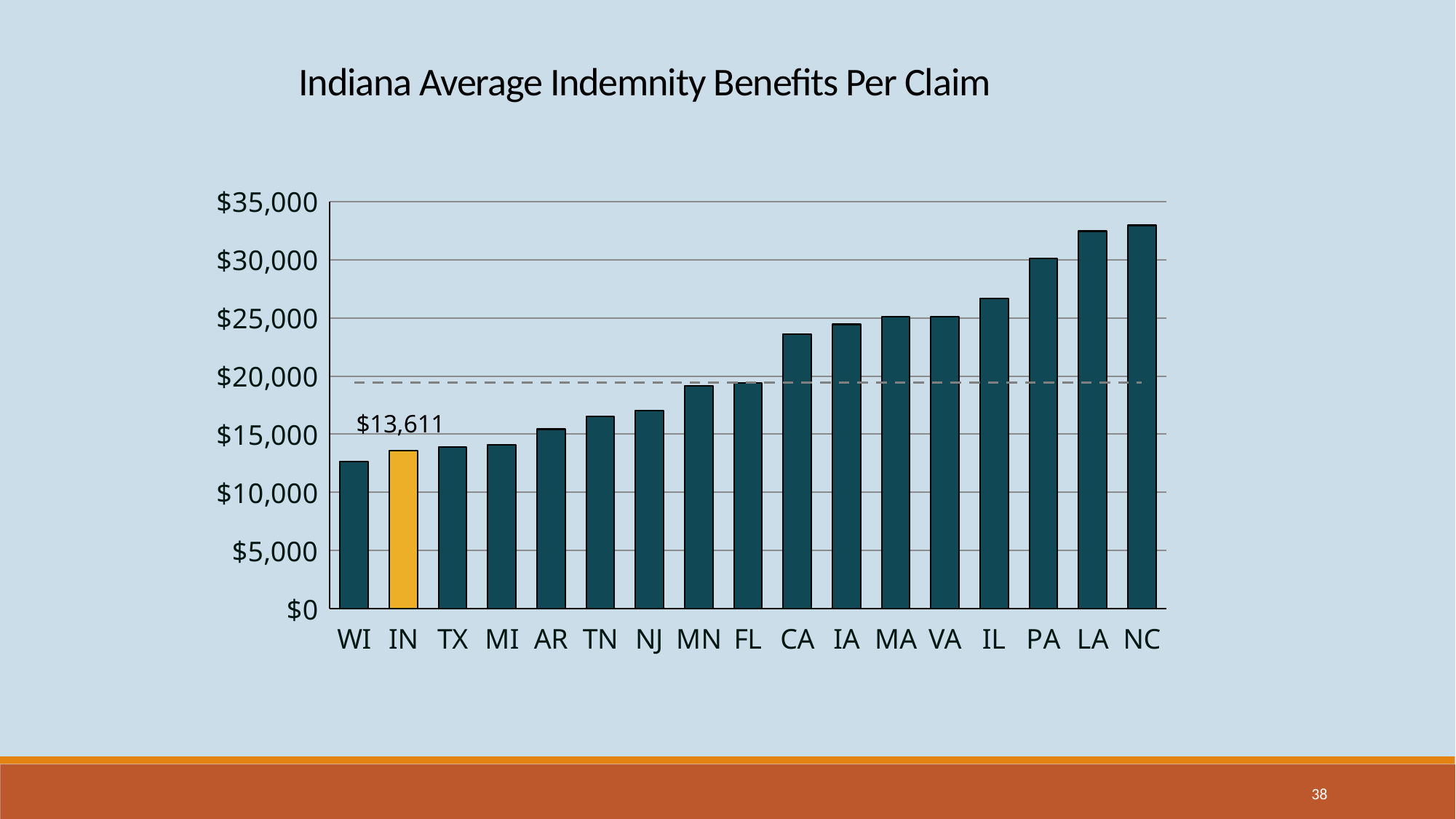
Which has a higher value, TX or CA? CA Which state has the lowest average indemnity benefit per claim? WI What is the title of the chart? Indiana Average Indemnity Benefits Per Claim What type of chart is shown on the slide? bar chart What is the value shown for IN? $13,611 Which state has the highest average indemnity benefit per claim? NC Is the value for IL greater or less than $25,000? greater Is the value for CA greater or less than $20,000? greater Is the value for WI greater or less than $15,000? less How many states are shown on the x axis? 17 Do the values generally rise or fall moving from left to right along the x axis? rise